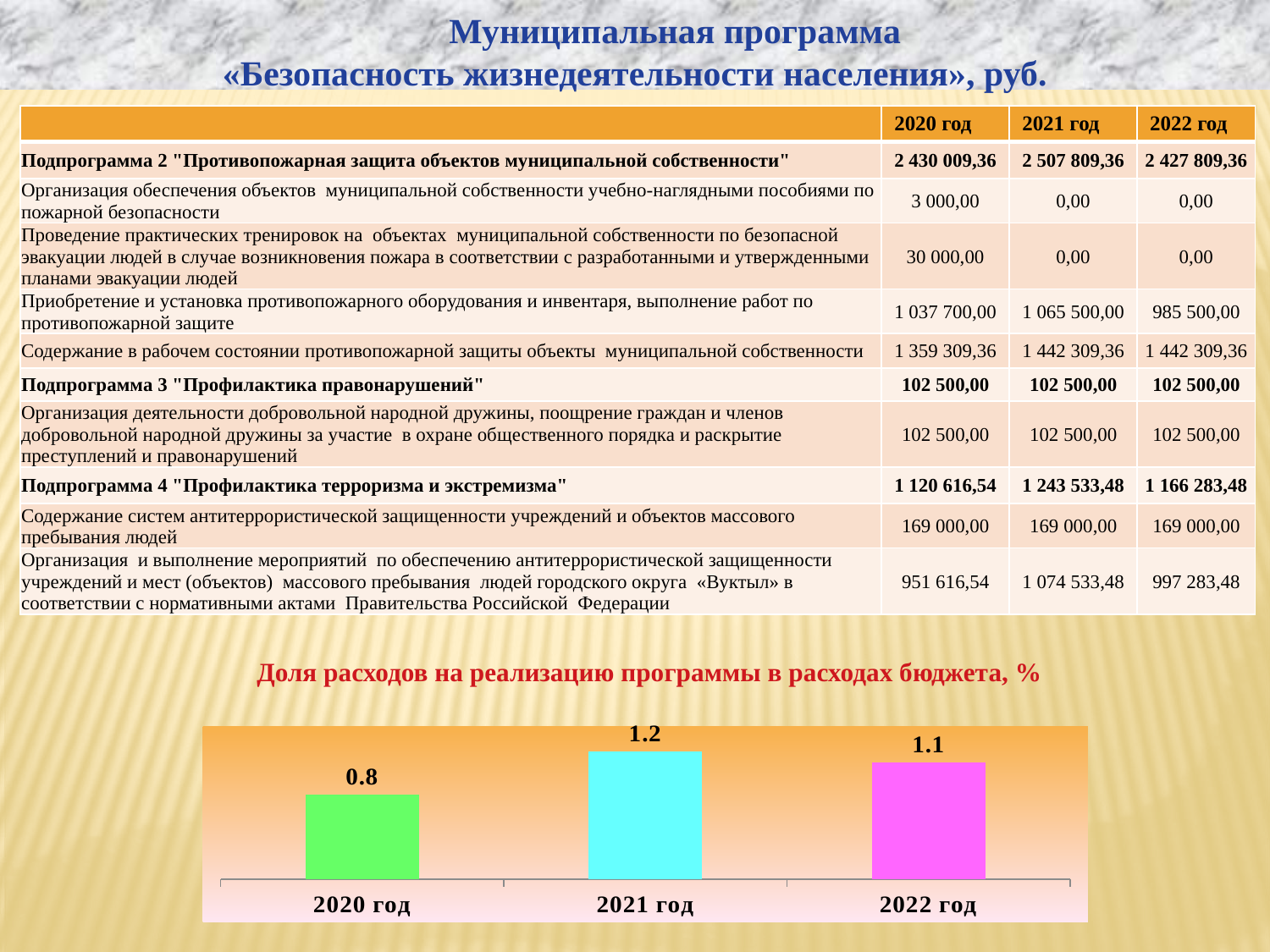
What is the value shown for 2020 год in the chart "Доля расходов на реализацию программы в расходах бюджета, %"? 0.8 What is the value shown for 2021 год in the chart? 1.2 What is the value shown for 2022 год in the chart? 1.1 What type of chart is shown at the bottom of the slide? Bar chart What is the difference between the values for 2021 год and 2020 год in the chart? 0.4 Which year has the lowest value in the chart? 2020 год Does the value rise or fall from 2021 год to 2022 год in the chart? Fall How many bars are shown in the chart? 3 Which year has the highest value in the chart? 2021 год What is the title of the chart at the bottom of the slide? Доля расходов на реализацию программы в расходах бюджета, % What is the difference between the values for 2021 год and 2022 год in the chart? 0.1 Which is larger in the chart: the value for 2022 год or the value for 2020 год? 2022 год